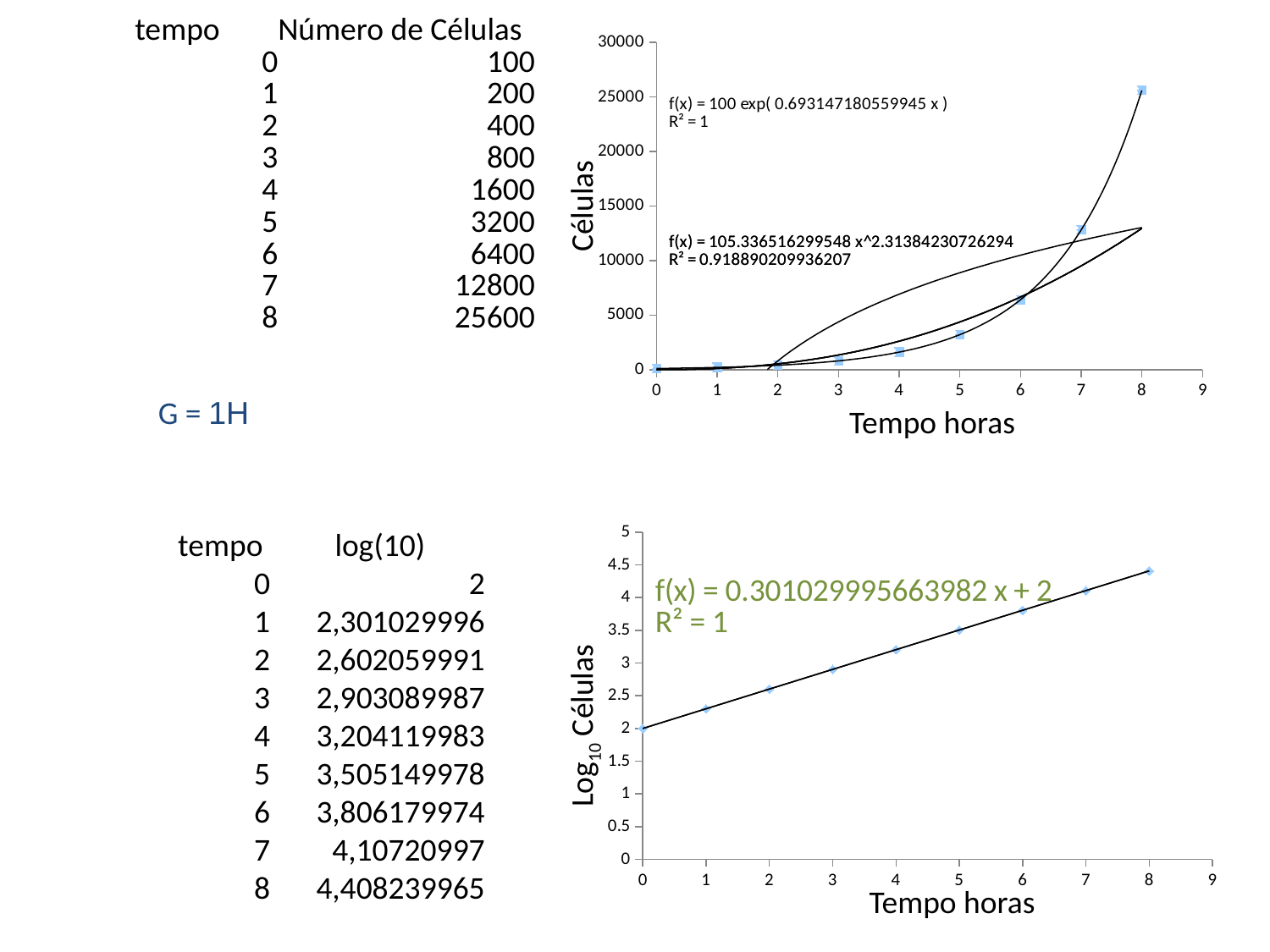
What kind of chart is the top chart (Células vs Tempo horas)? scatter chart In the bottom chart (Log10 Células vs Tempo horas), what is the value at time 0? 2 What is the x-axis title of the top chart? Tempo horas What kind of chart is the bottom chart (Log10 Células vs Tempo horas)? scatter chart What R² value is shown for the fitted line in the bottom chart (Log10 Células vs Tempo horas)? 1 In the top chart (Células vs Tempo horas), what is the difference between the number of cells at time 8 and at time 7? 12800 In the top chart (Células vs Tempo horas), do the values rise or fall as time increases? rise In the bottom chart (Log10 Células vs Tempo horas), is the value at time 8 greater or less than 4? greater In the top chart (Células vs Tempo horas), is the value at time 7 greater or less than 10000? greater In the top chart (Células vs Tempo horas), which time has the highest number of cells? 8 In the top chart (Células vs Tempo horas), how many data points are plotted? 9 In the top chart (Células vs Tempo horas), what is the number of cells at time 8? 25600